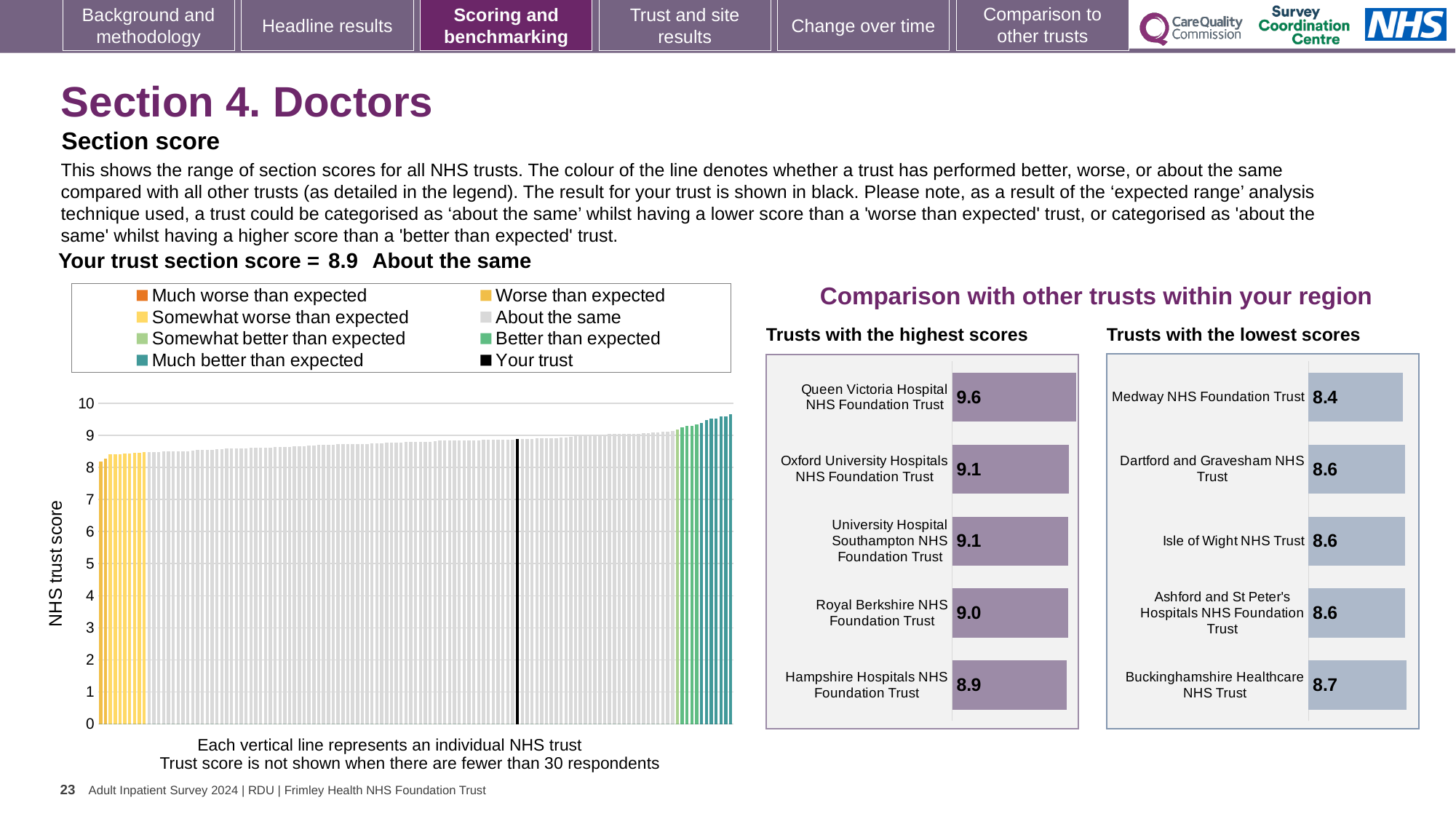
In the 'Trusts with the lowest scores' chart, what is the score for Buckinghamshire Healthcare NHS Trust? 8.7 How many entries does the legend of the NHS trust score chart on the left list? 8 In the 'Trusts with the lowest scores' chart, what is the difference between the scores of Buckinghamshire Healthcare NHS Trust and Medway NHS Foundation Trust? 0.3 In the 'Trusts with the lowest scores' chart, which trust has the lowest score? Medway NHS Foundation Trust In the 'Trusts with the highest scores' chart, what is the difference between the scores of Queen Victoria Hospital NHS Foundation Trust and Hampshire Hospitals NHS Foundation Trust? 0.7 In the NHS trust score chart on the left, do the bar values rise or fall from left to right? Rise In the 'Trusts with the highest scores' chart, what is the score for Queen Victoria Hospital NHS Foundation Trust? 9.6 In the 'Trusts with the lowest scores' chart, what is the score for Medway NHS Foundation Trust? 8.4 In the 'Trusts with the highest scores' chart, which has the larger score: Royal Berkshire NHS Foundation Trust or Hampshire Hospitals NHS Foundation Trust? Royal Berkshire NHS Foundation Trust What kind of chart is the NHS trust score chart on the left of the slide? Bar chart In the 'Trusts with the highest scores' chart, which trust has the highest score? Queen Victoria Hospital NHS Foundation Trust How many trusts are listed in the 'Trusts with the highest scores' chart? 5